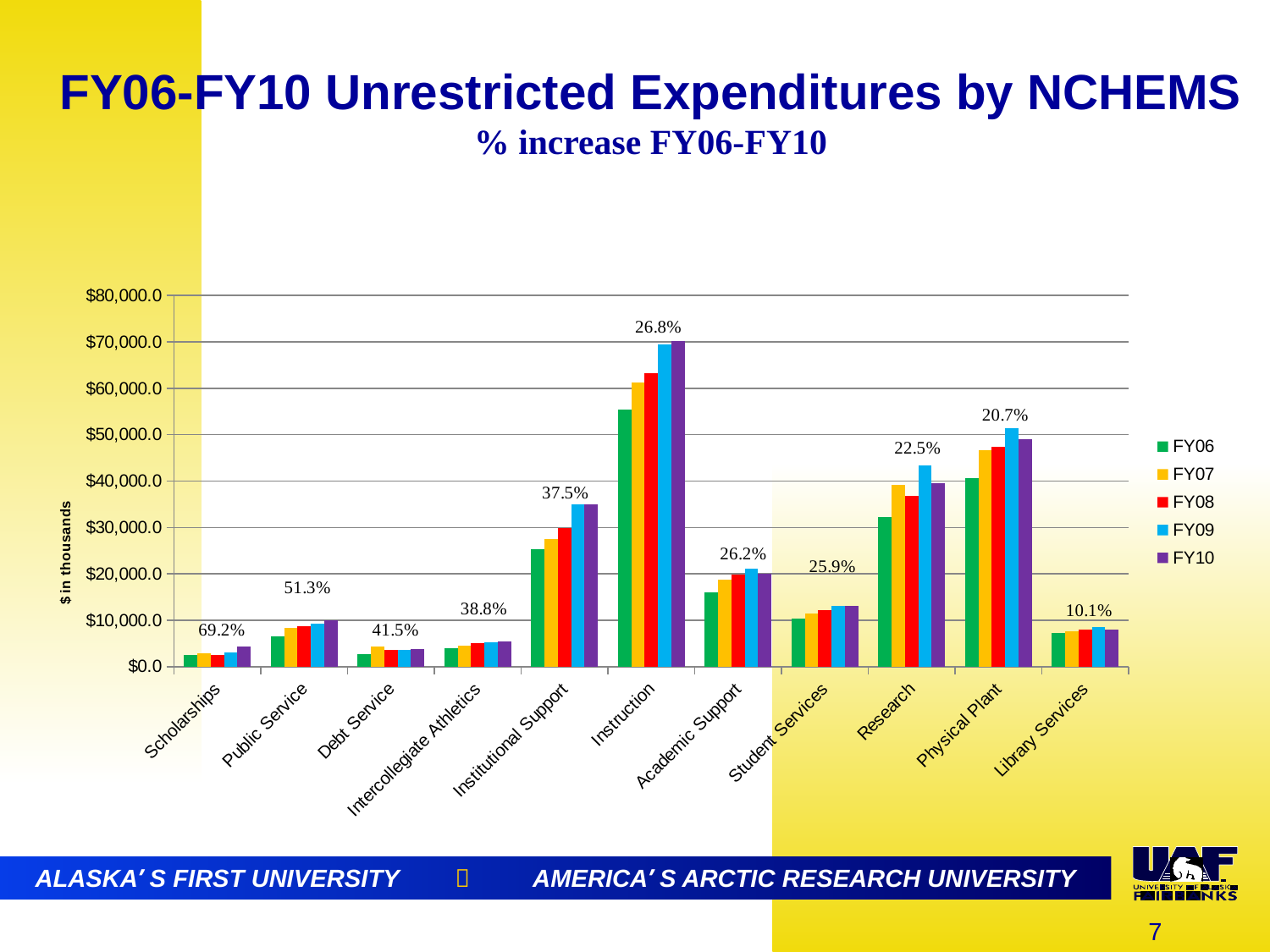
How many expenditure categories are shown along the x axis? 11 What is the difference between the printed % increase for Public Service and for Debt Service? 9.8% What kind of chart is shown on the slide? bar chart Which category has the tallest bars in the chart? Instruction What % increase FY06-FY10 is printed above the Scholarships group? 69.2% Is the FY10 value for Library Services greater or less than $10,000.0? less Which category has the lowest printed % increase FY06-FY10? Library Services Is the FY06 value for Instruction greater or less than $50,000.0? greater What % increase FY06-FY10 is printed above the Instruction group? 26.8% What % increase FY06-FY10 is printed above the Physical Plant group? 20.7% How many series does the legend list? 5 What is the label on the vertical axis? $ in thousands